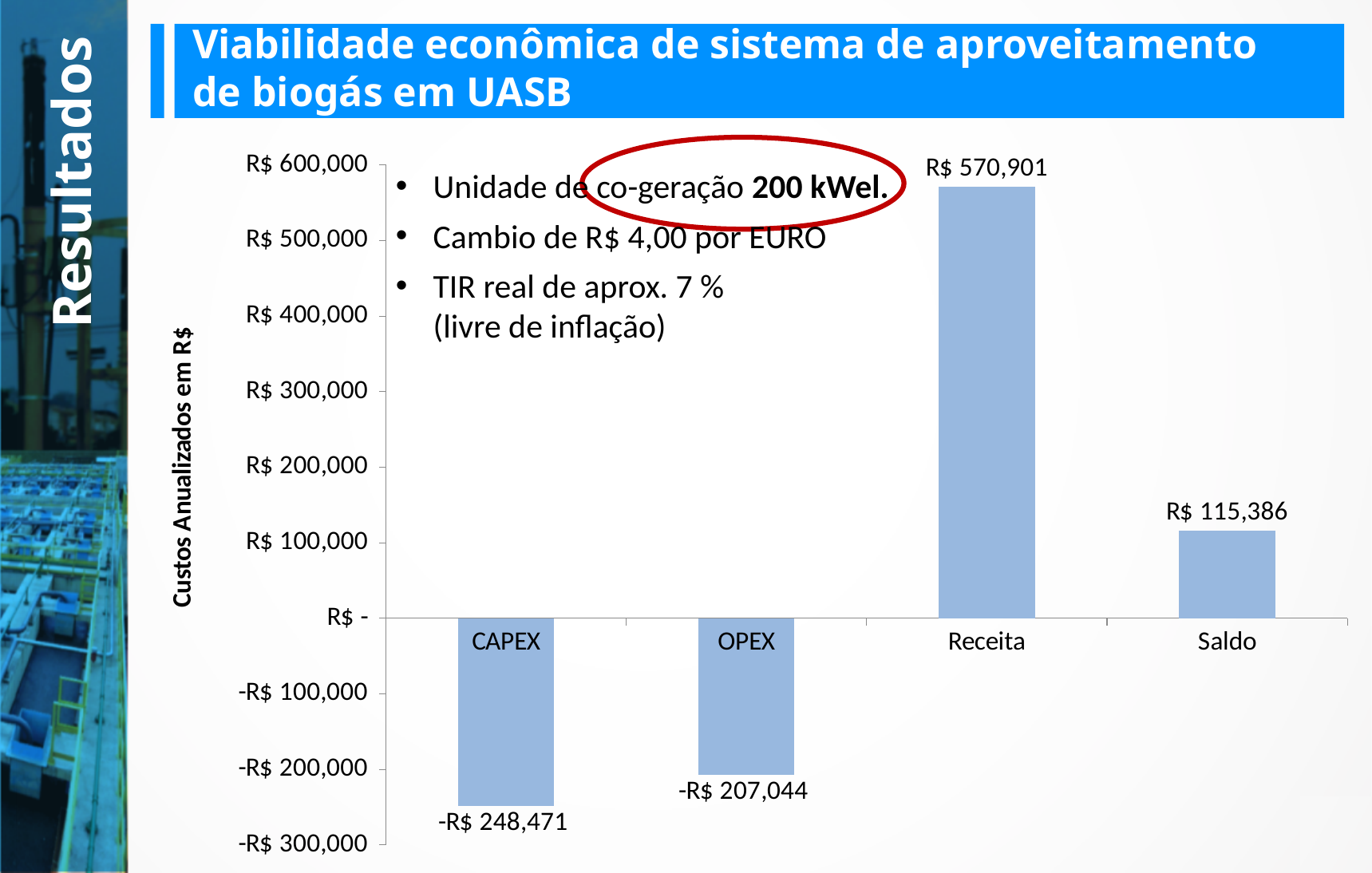
How many categories are shown on the x axis? 4 What is the difference between the Receita value and the Saldo value? R$ 455,515 What is the label of the vertical axis? Custos Anualizados em R$ Which category has the lowest value? CAPEX What is the value shown for Saldo? R$ 115,386 What is the value shown for Receita? R$ 570,901 What is the value shown for CAPEX? -R$ 248,471 Which has the larger negative value, CAPEX or OPEX? CAPEX Is the value for Receita greater or less than R$ 500,000? greater Which category has the highest value? Receita What kind of chart is shown on the slide? bar chart What is the value shown for OPEX? -R$ 207,044